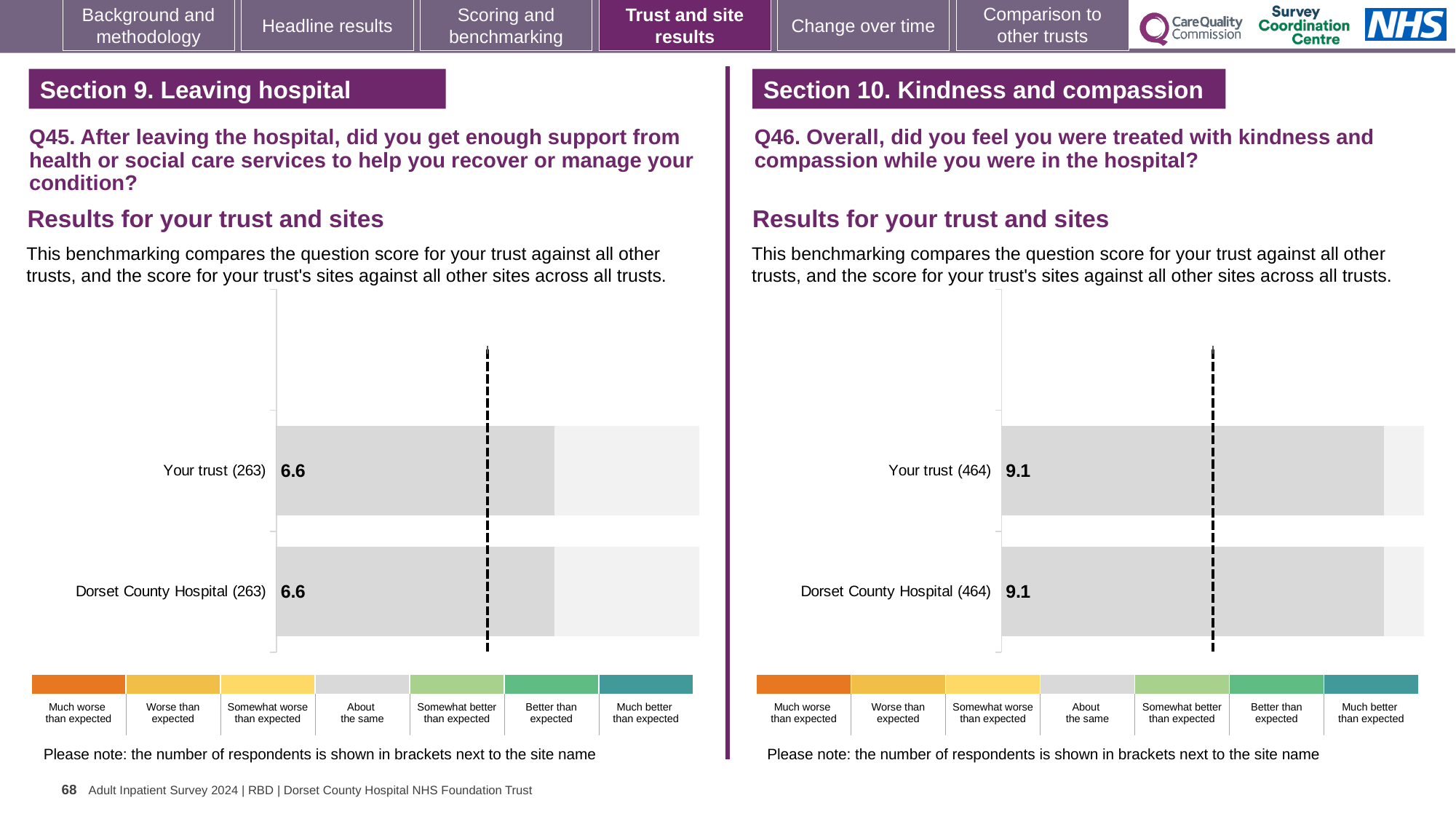
On the Q46 chart (right), what is the score for Dorset County Hospital? 9.1 What kind of chart is used for the Q46 results (right)? Bar chart On the Q45 chart (left), what is the difference between the score for Your trust and the score for Dorset County Hospital? 0.0 On the Q46 chart (right), how many respondents are shown in brackets for Dorset County Hospital? 464 On the Q46 chart (right), what is the difference between the score for Your trust and the score for Dorset County Hospital? 0.0 On the Q46 chart (right), which benchmark category does the grey colour of the bars correspond to in the legend? About the same On the Q45 chart (left), what is the score for Your trust? 6.6 How many bars are plotted on the Q45 chart (left)? 2 On the Q45 chart (left), how many respondents are shown in brackets for Your trust? 263 How many bars are plotted on the Q46 chart (right)? 2 On the Q45 chart (left), what is the score for Dorset County Hospital? 6.6 On the Q46 chart (right), what is the score for Your trust? 9.1